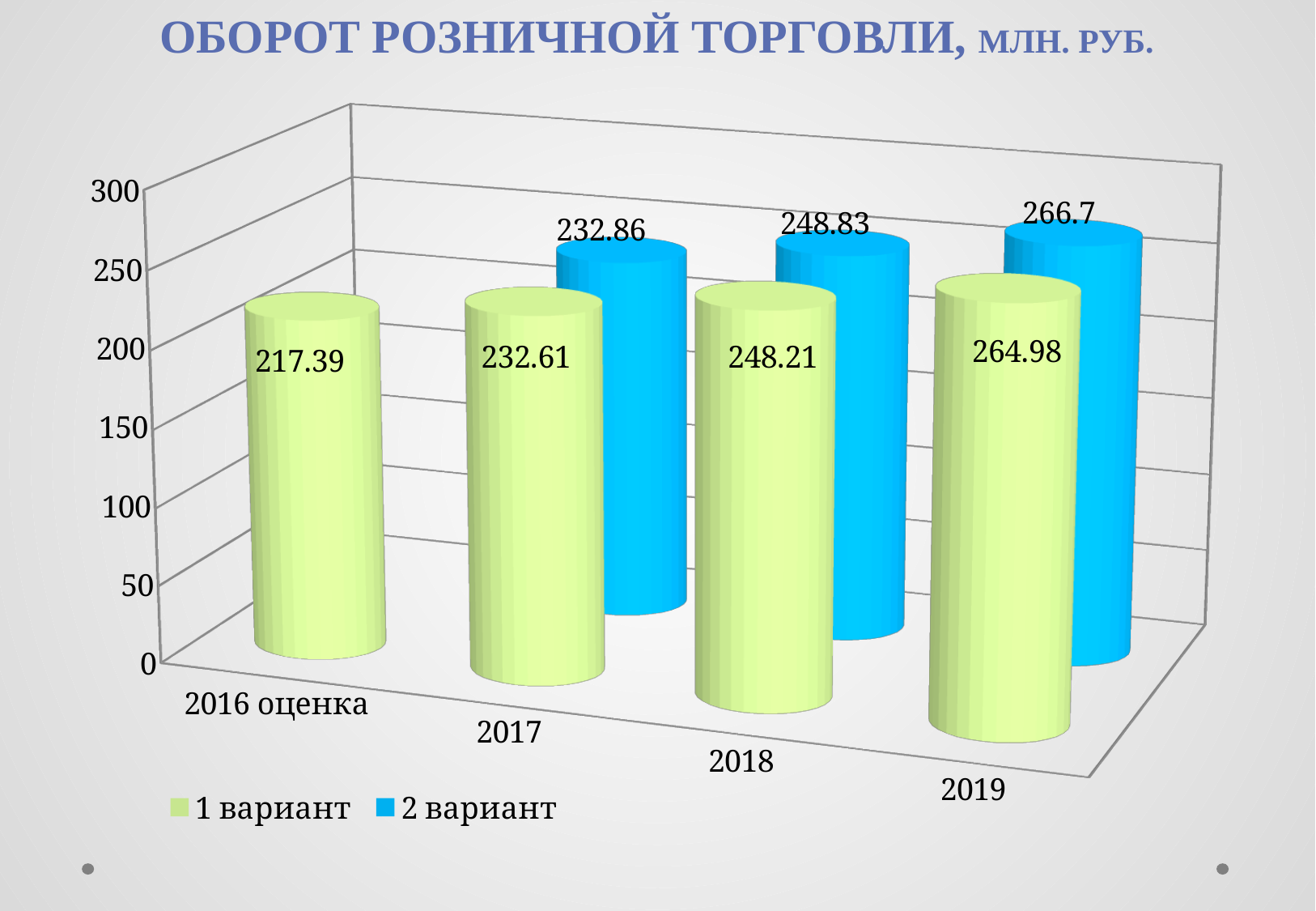
What is the difference between the 1 вариант values for 2019 and 2016 оценка? 47.59 Which year has the highest value for 1 вариант? 2019 Is the value for 1 вариант in 2016 оценка greater or less than 200? greater Which category has the lowest value for 1 вариант? 2016 оценка What is the value for 2 вариант in 2017? 232.86 How many categories are shown on the x axis? 4 What is the difference between the 2 вариант and 1 вариант values in 2019? 1.72 What is the value for 2 вариант in 2019? 266.7 How many series does the legend list? 2 Do the values for 1 вариант rise or fall from 2016 оценка to 2019? rise What is the value for 1 вариант in 2016 оценка? 217.39 What is the value for 1 вариант in 2018? 248.21